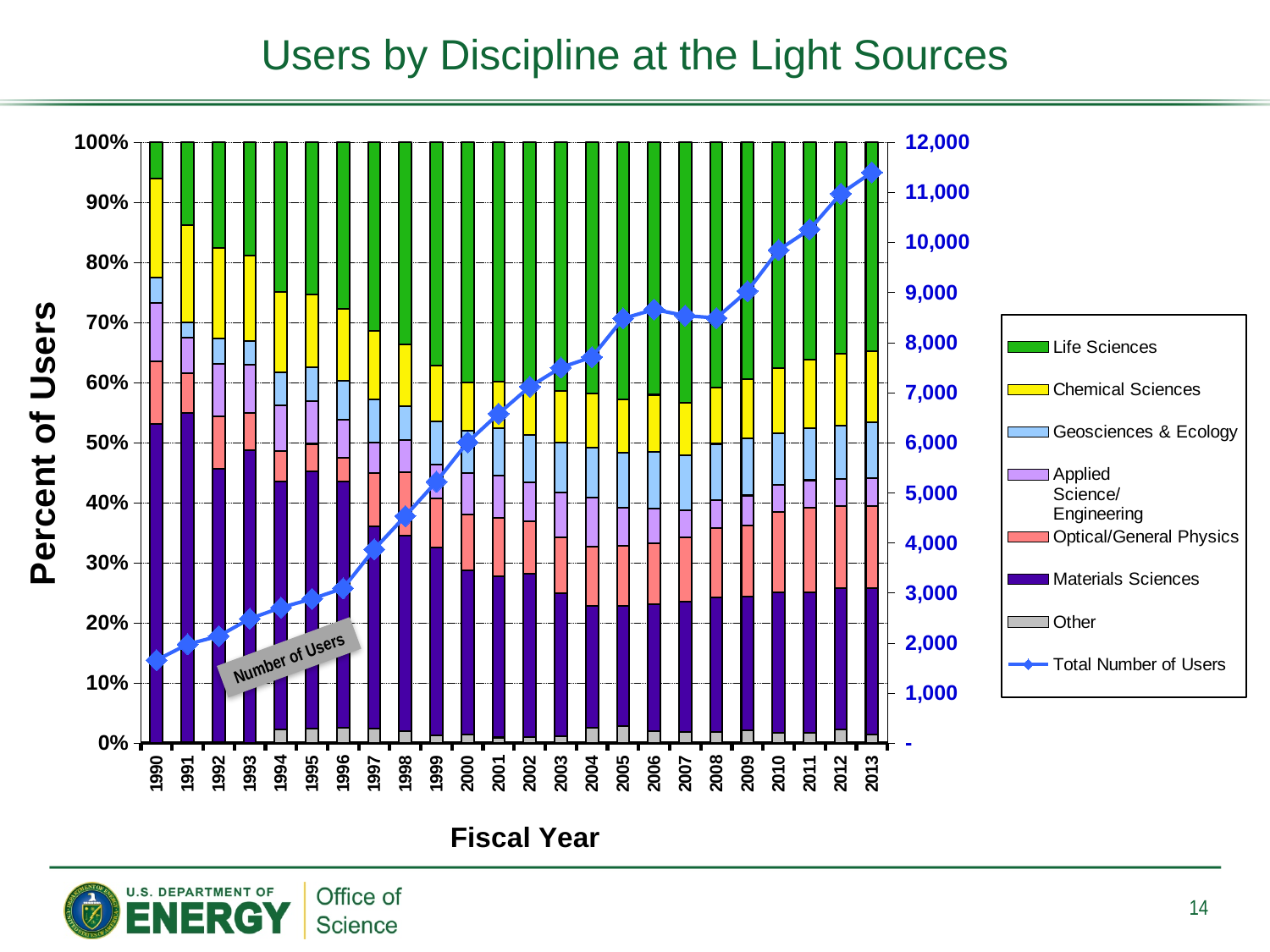
Is the Total Number of Users in 2005 greater or less than 8,000? greater Is the Total Number of Users in 1990 greater or less than 2,000? less Is the Total Number of Users in 2013 greater or less than 11,000? greater Which fiscal year has the highest Total Number of Users? 2013 What kind of chart is shown on the slide? Stacked bar chart with a line overlay What is the title of the chart? Users by Discipline at the Light Sources How many entries does the legend list? 8 Is the Materials Sciences share of users larger in 1991 or in 2013? 1991 How many fiscal years are shown along the x axis? 24 Which fiscal year has the lowest Total Number of Users? 1990 Does the Total Number of Users line rise or fall from 1990 to 2013? Rises